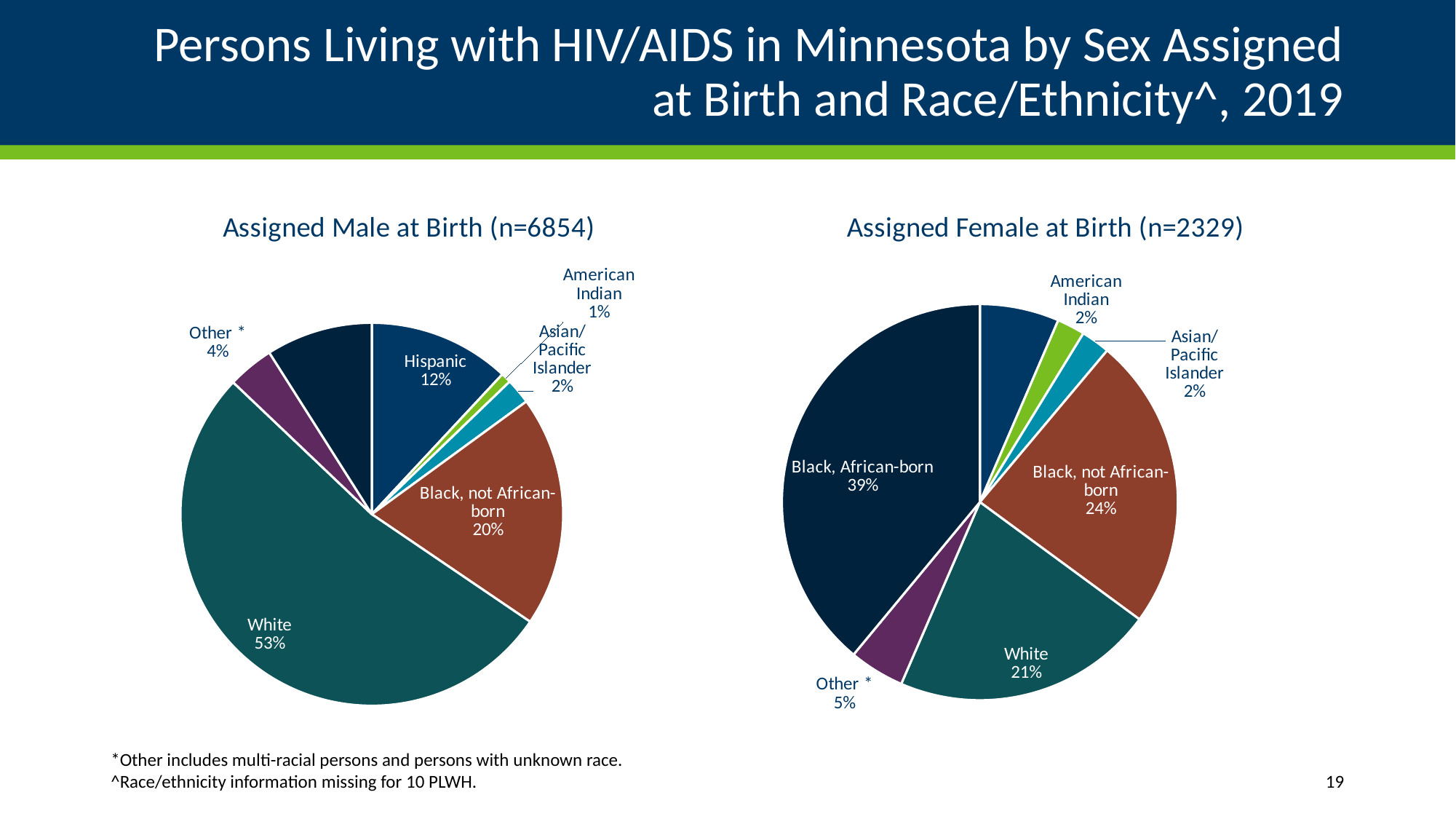
In the Assigned Female at Birth chart, what is the difference in percentage points between Black, not African-born and White? 3 What type of chart is used on this slide? Pie chart In the Assigned Female at Birth chart, what share of persons are Black, African-born? 39% In the Assigned Male at Birth chart, which labelled group has the smallest share? American Indian In the Assigned Male at Birth chart, what percentage is Hispanic? 12% In the Assigned Male at Birth chart, what is the difference in percentage points between White and Black, not African-born? 33 In the Assigned Male at Birth chart, what share of persons are White? 53% In the Assigned Female at Birth chart, what percentage is Black, not African-born? 24% Which is larger in the Assigned Female at Birth chart: the White share or the Other share? White In the Assigned Male at Birth chart, which labelled race/ethnicity group has the largest share? White What is the n value shown in the title of the Assigned Female at Birth chart? 2329 In the Assigned Female at Birth chart, which labelled group has the largest share? Black, African-born